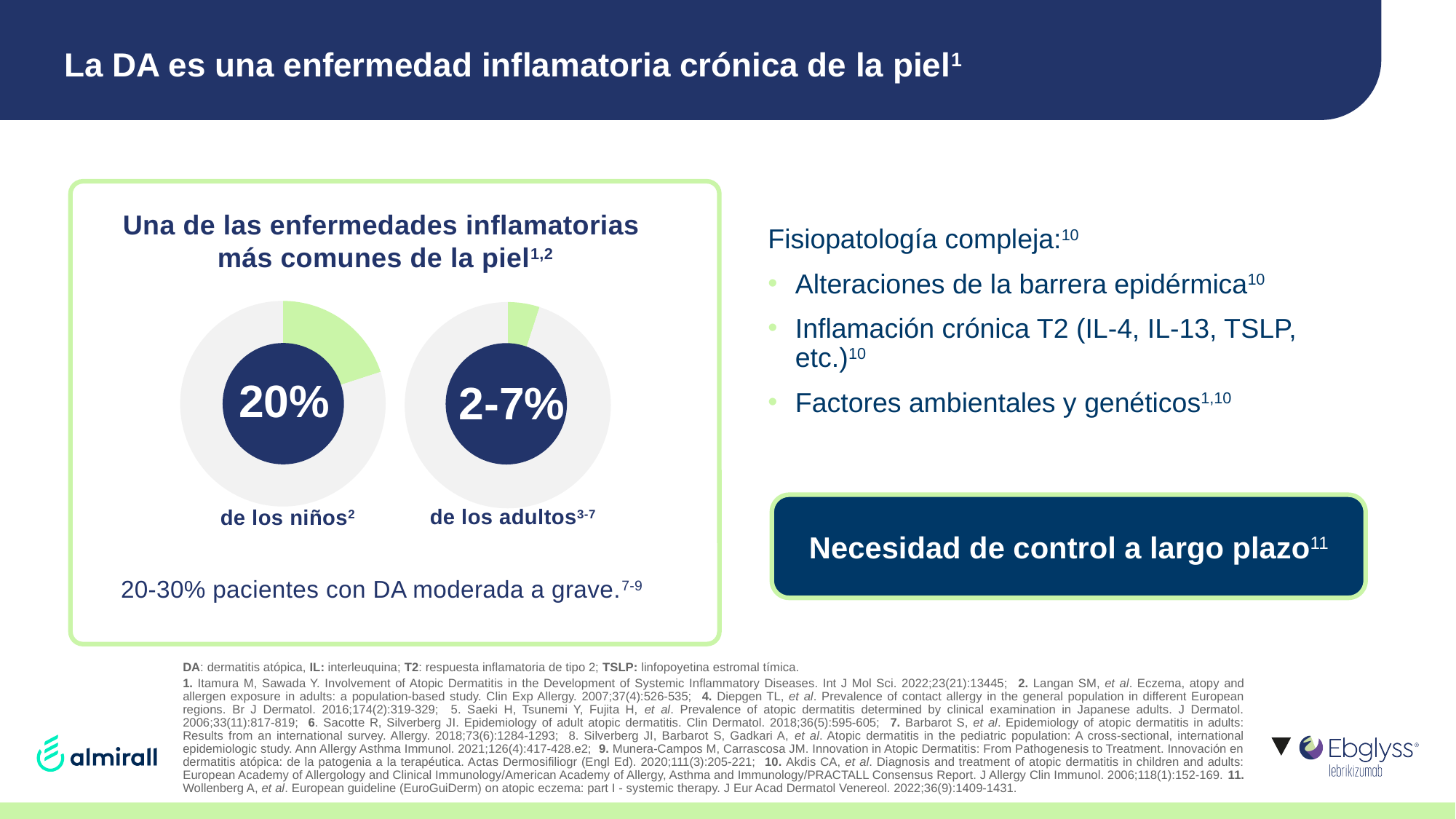
Which of the two donut charts shows the highest value? de los niños How many donut charts are shown on the slide? 2 What colour is the highlighted slice in the donut charts? green Which group has the higher prevalence shown in the donut charts, niños or adultos? niños In the left donut chart, what share of the ring does the green slice represent? 20% What kind of chart is used to show the prevalence in children and adults? donut (pie) chart Which of the two donut charts shows the lowest value? de los adultos In the left donut chart, what percentage is shown for 'de los niños'? 20% Is the value shown in the donut chart for 'de los niños' greater or less than 10%? greater What is the heading above the two donut charts? Una de las enfermedades inflamatorias más comunes de la piel In the right donut chart, what value is shown for 'de los adultos'? 2-7%